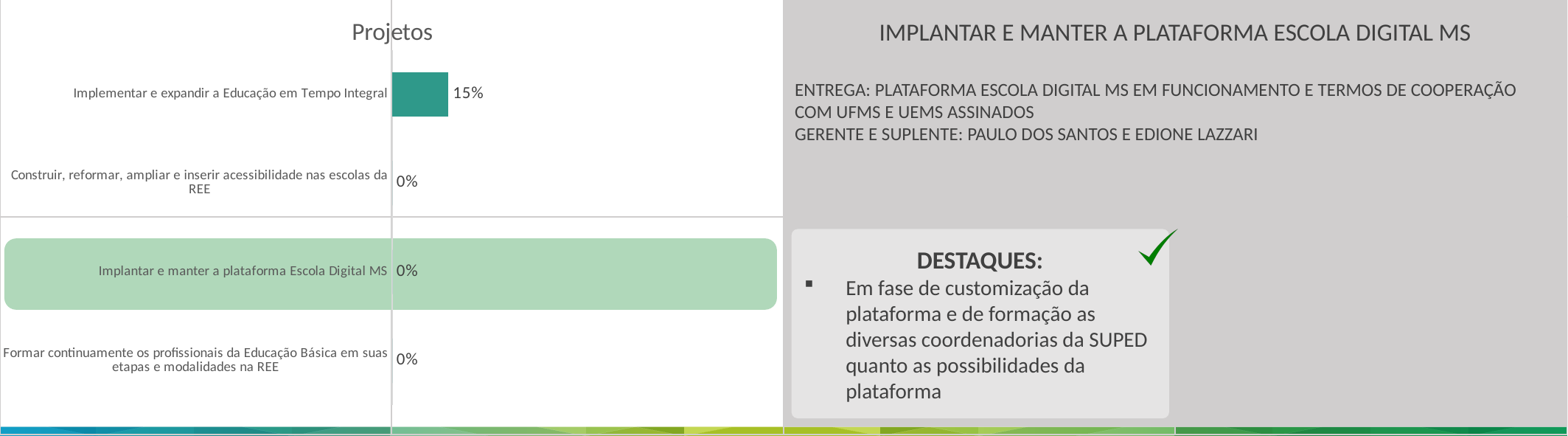
What is the value for "Implementar e expandir a Educação em Tempo Integral" in the Projetos chart? 15% In the Projetos chart, which is larger: the value for "Implementar e expandir a Educação em Tempo Integral" or the value for "Construir, reformar, ampliar e inserir acessibilidade nas escolas da REE"? Implementar e expandir a Educação em Tempo Integral Which category has the highest value in the Projetos chart? Implementar e expandir a Educação em Tempo Integral How many categories in the Projetos chart have a value of 0%? 3 What is the value for "Formar continuamente os profissionais da Educação Básica em suas etapas e modalidades na REE" in the Projetos chart? 0% What is the value for "Construir, reformar, ampliar e inserir acessibilidade nas escolas da REE" in the Projetos chart? 0% What is the title of the chart on the left side of the slide? Projetos Which category in the Projetos chart is highlighted with a green background? Implantar e manter a plataforma Escola Digital MS How many categories are shown in the Projetos chart? 4 What is the difference between the values for "Implementar e expandir a Educação em Tempo Integral" and "Implantar e manter a plataforma Escola Digital MS" in the Projetos chart? 15% What kind of chart is the Projetos chart? Bar chart What is the value for "Implantar e manter a plataforma Escola Digital MS" in the Projetos chart? 0%